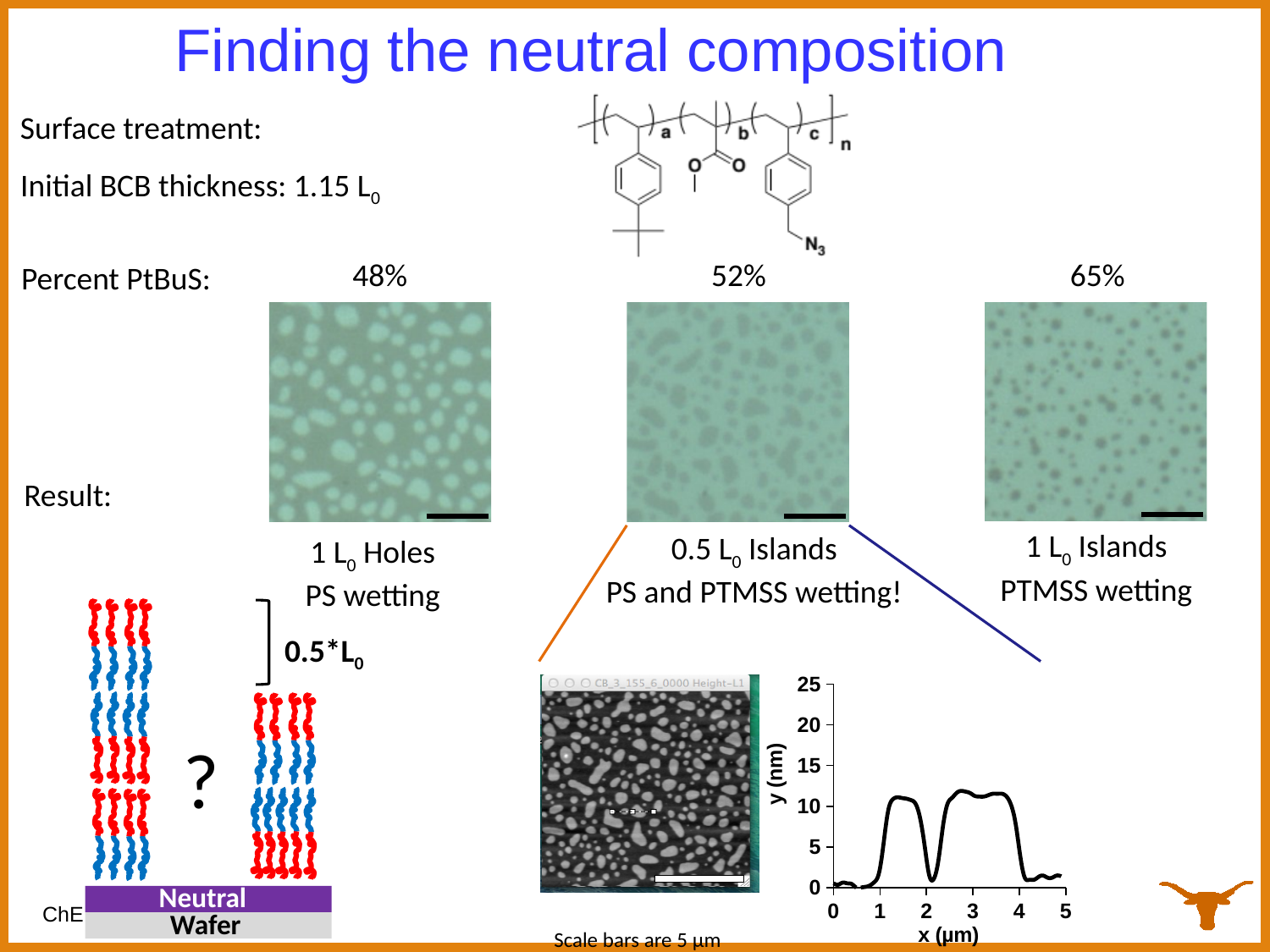
In the line chart, is the peak value of the profile greater or less than 5? greater In the line chart, is the peak value of the profile greater or less than 15? less In the line chart, is the value at x = 4.5 greater or less than 5? less In the line chart, is the value at x = 1.5 larger or smaller than the value at x = 2? larger What is the label of the x axis of the line chart? x (μm) What is the label of the y axis of the line chart? y (nm) What is the maximum value shown on the y axis of the line chart? 25 What kind of chart is shown at the bottom right of the slide? line chart